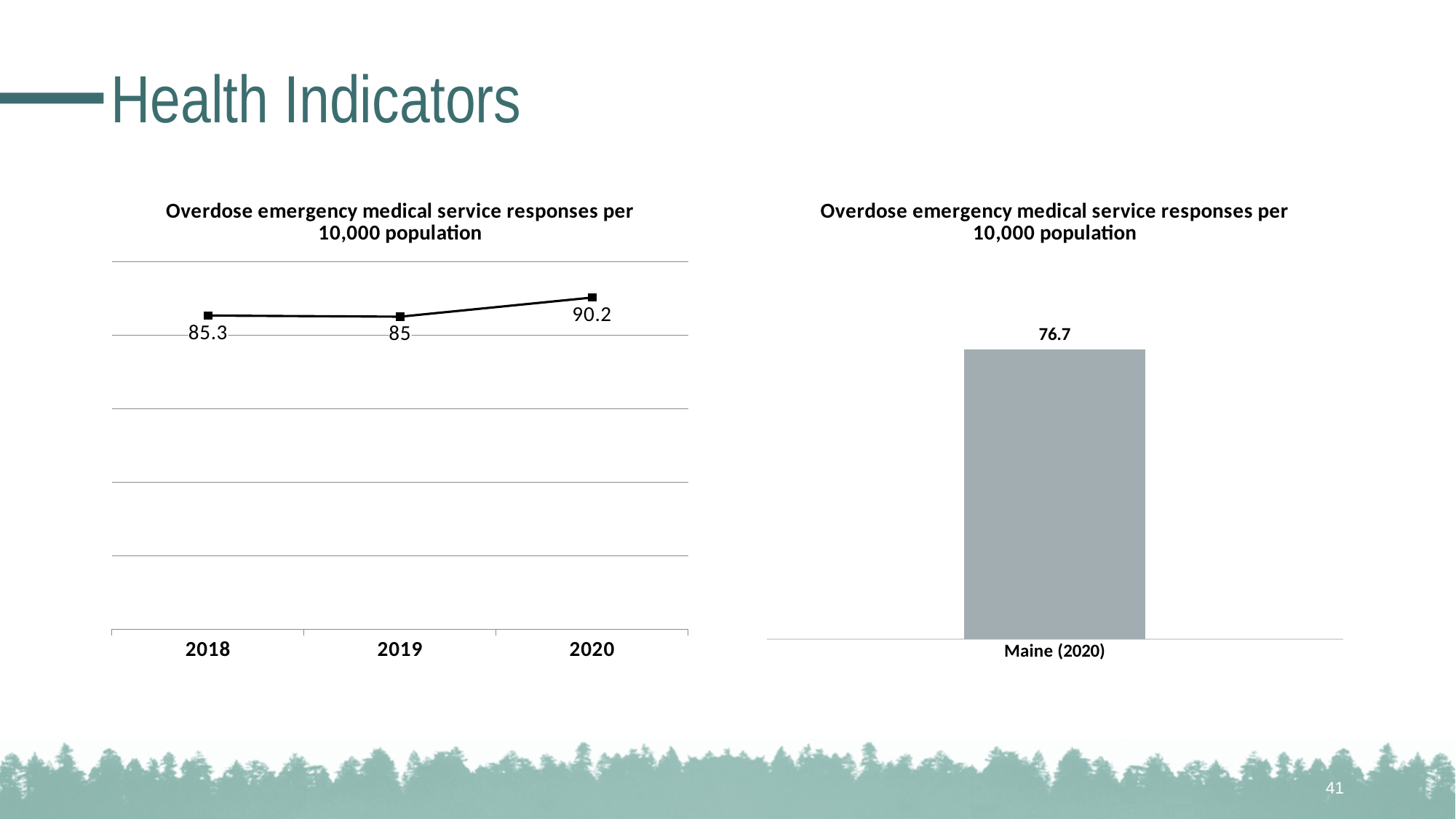
What kind of chart is the chart on the right? Bar chart In the left chart, what is the value for 2020? 90.2 In the left chart, what is the difference between the 2018 and 2019 values? 0.3 In the left chart, what is the difference between the 2020 and 2019 values? 5.2 In the left chart, what is the value for 2019? 85 In the right chart, what is the value for Maine (2020)? 76.7 In the left chart, which year has the lowest value? 2019 What kind of chart is the chart on the left? Line chart Which is larger: the 2020 value in the left chart or the Maine (2020) value in the right chart? The 2020 value in the left chart (90.2) In the left chart, which year has the highest value? 2020 In the left chart, what is the value for 2018? 85.3 How many data points are plotted in the left chart? 3